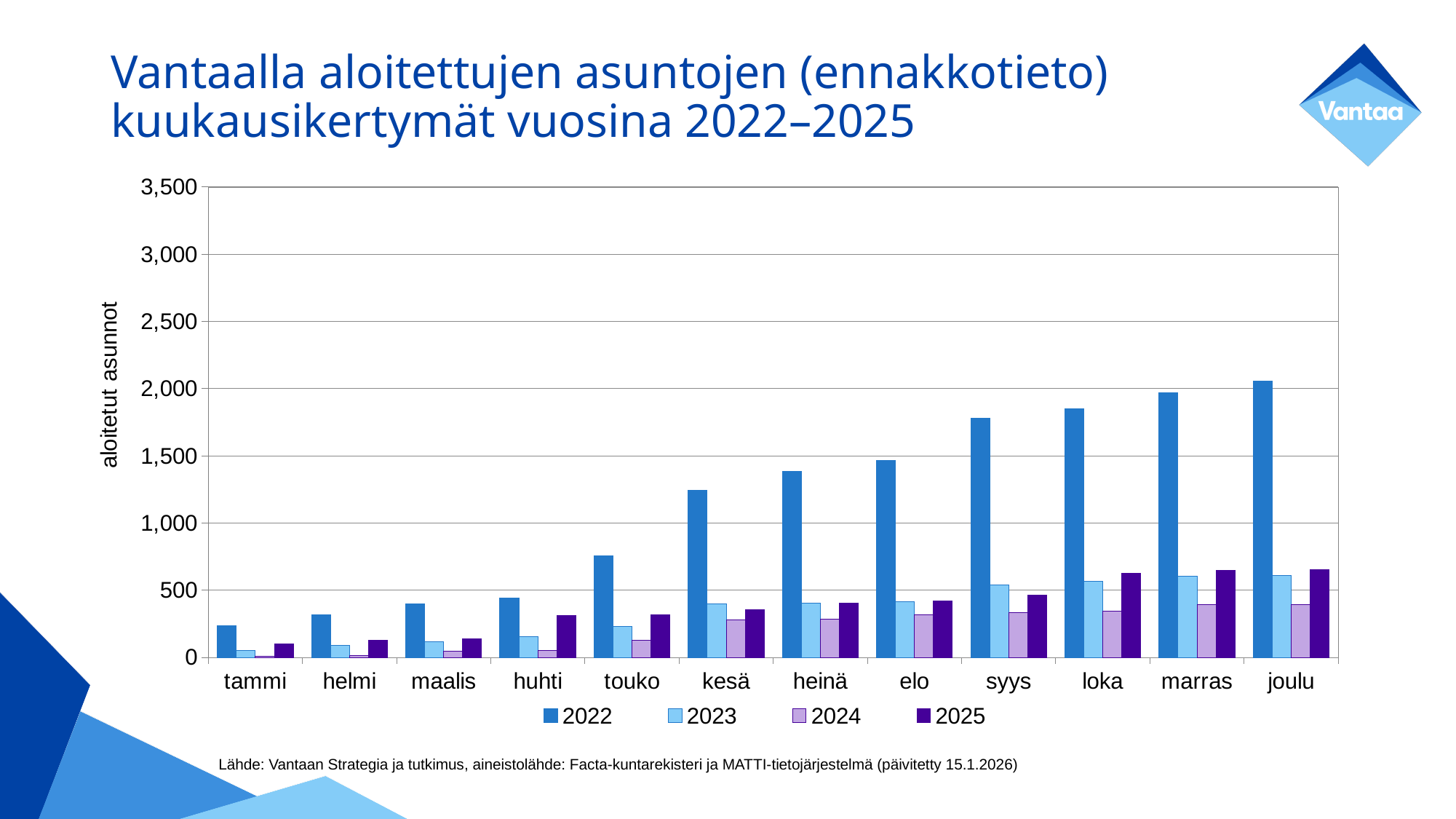
Do the values of the 2022 series rise or fall from tammi to joulu? rise In loka, which series has the larger value, 2024 or 2025? 2025 What kind of chart is shown on the slide? bar chart How many months are shown on the x axis? 12 Is the 2023 value for joulu greater or less than 500? greater Is the 2022 value for tammi greater or less than 500? less How many series does the legend list? 4 Is the 2022 value for kesä greater or less than 1,000? greater Which month has the lowest value for the 2024 series? tammi What is the title of the vertical axis? aloitetut asunnot Which month has the highest value for the 2022 series? joulu